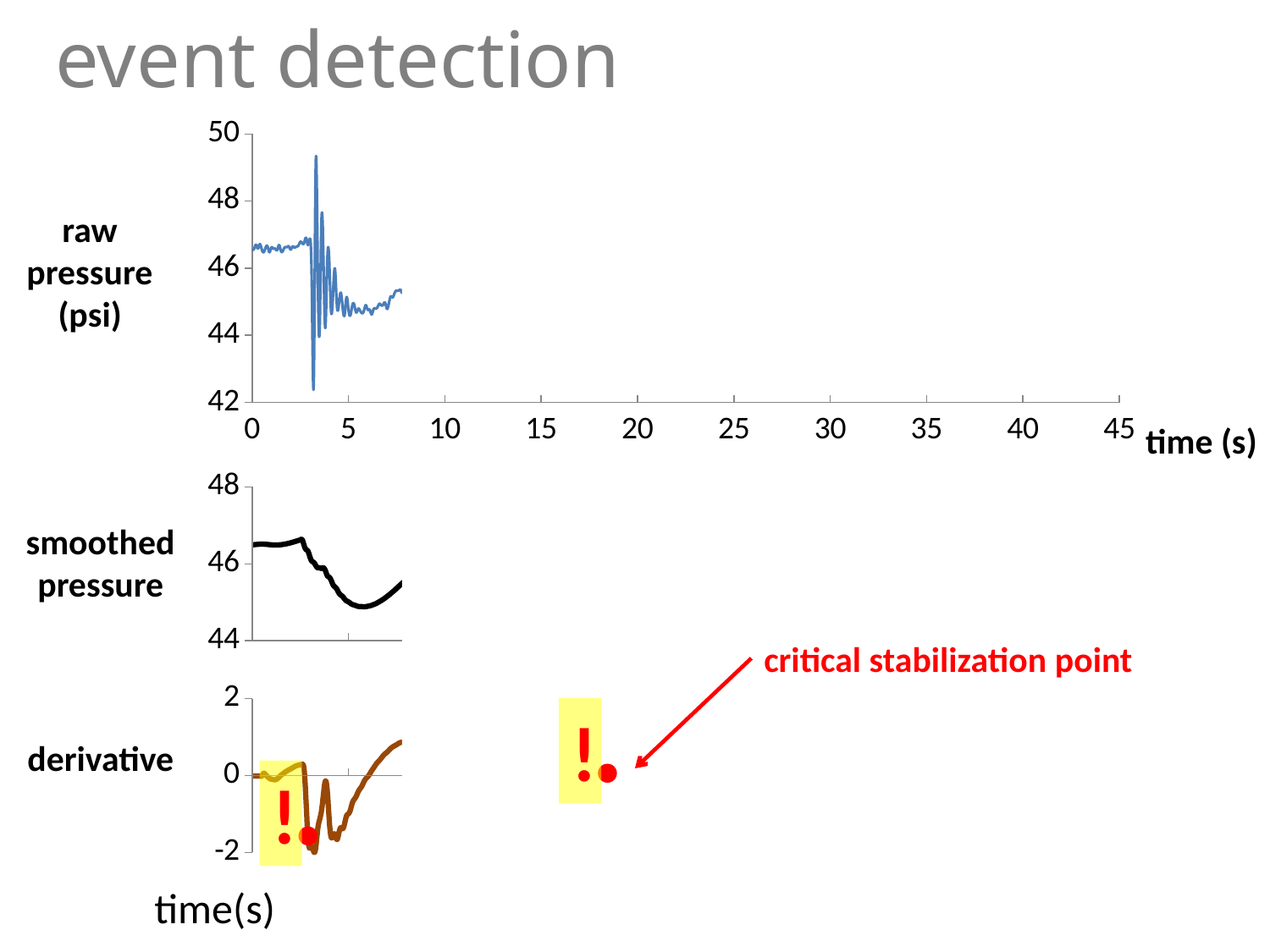
What is the largest tick value on the x axis of the raw pressure chart? 45 On the raw pressure chart, is the value at time 0 greater or less than 46? greater On the smoothed pressure chart, is the value at the start of the line greater or less than 46? greater On the raw pressure chart, is the lowest dip greater or less than 44? less What kind of chart is the raw pressure chart? line chart On the smoothed pressure chart, does the line rise or fall between the start and about 5 seconds? fall What is the label on the x axis of the raw pressure chart? time (s) How many charts are shown on the slide? 3